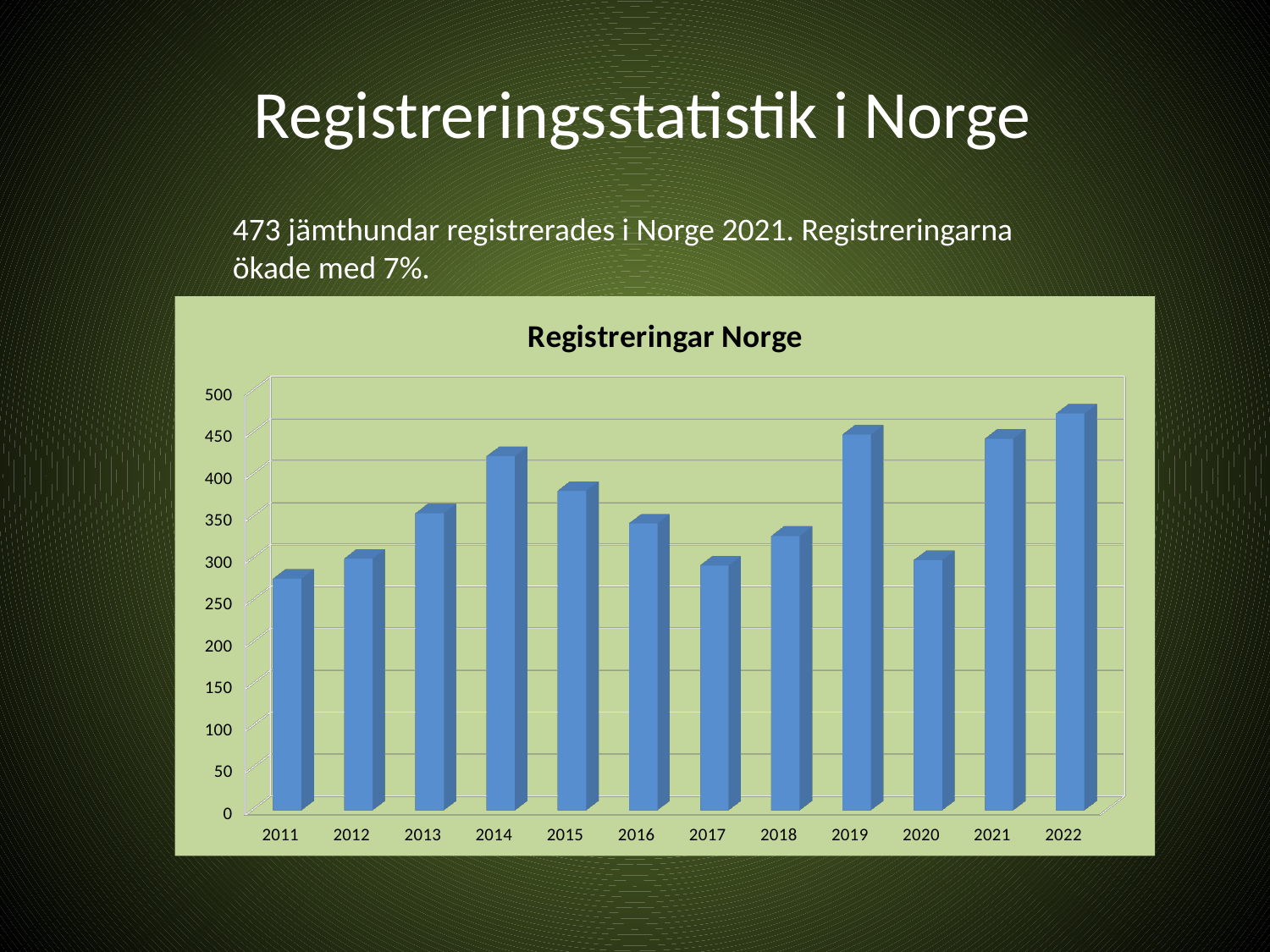
Is the value for 2014 greater or less than 400? greater What is the title of the chart? Registreringar Norge Is the value for 2018 greater or less than 350? less Is the value for 2011 greater or less than 300? less Which year has the highest bar in the chart? 2022 Which is larger, the value for 2019 or the value for 2020? 2019 How many years are shown on the x axis of the chart? 12 Do the values rise or fall from 2011 to 2014? rise What kind of chart is shown on the slide? bar chart Which is larger, the value for 2014 or the value for 2015? 2014